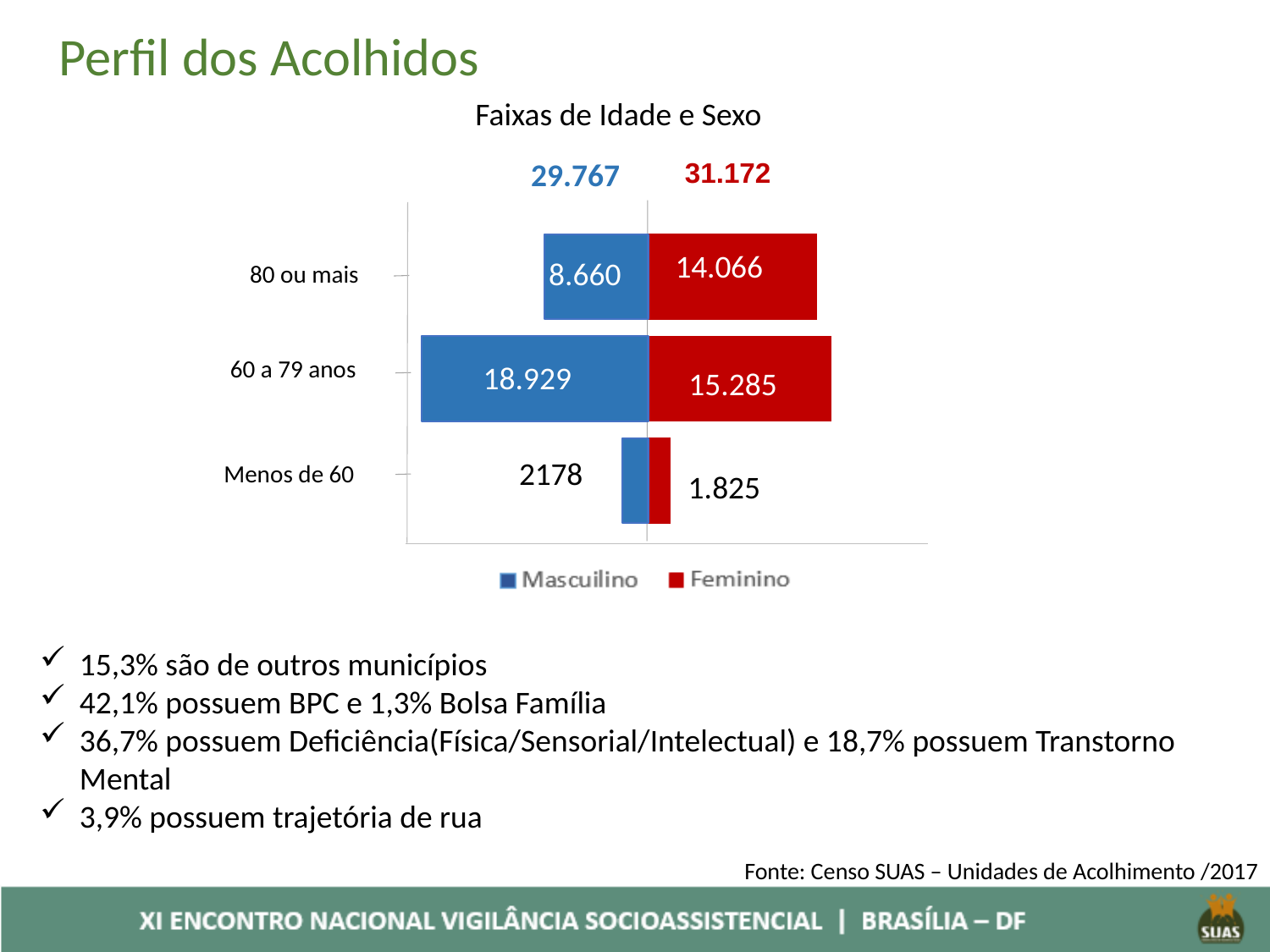
How many age groups are shown in the chart? 3 What is the Feminino value for the 60 a 79 anos age group? 15.285 How many series does the legend list? 2 Which age group has the highest Masculino value? 60 a 79 anos Which age group has the lowest Feminino value? Menos de 60 Which is larger for the 80 ou mais group, Masculino or Feminino? Feminino What is the difference between the Feminino and Masculino values for 80 ou mais? 5.406 What is the Masculino value for Menos de 60? 2178 What is the Feminino value for Menos de 60? 1.825 What is the difference between the Masculino and Feminino values for 60 a 79 anos? 3.644 What is the Masculino value for the 80 ou mais age group? 8.660 What type of chart is shown on the slide? Bar chart